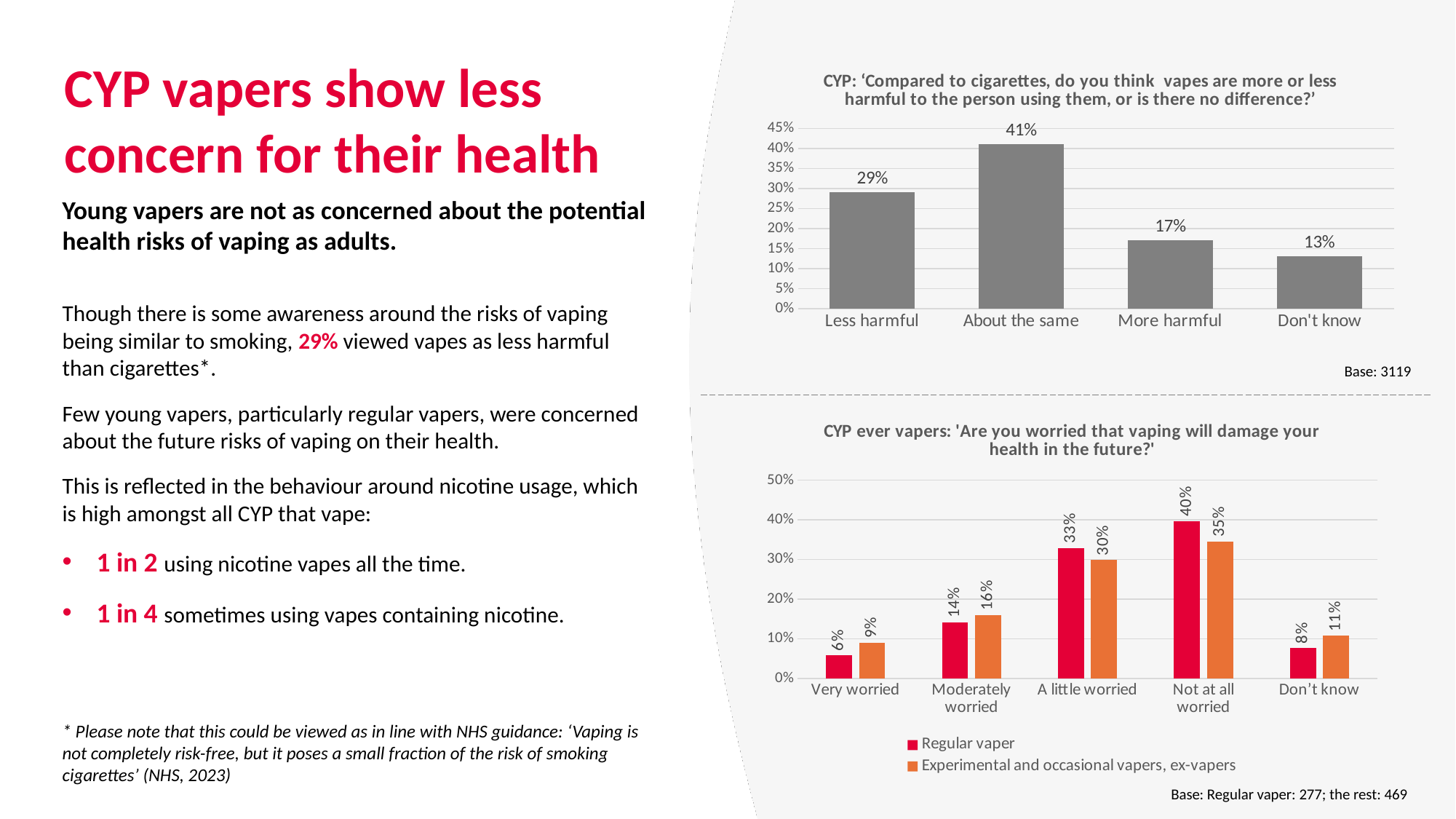
In the bottom chart ('Are you worried that vaping will damage your health in the future?'), how many series does the legend list? 2 In the bottom chart ('Are you worried that vaping will damage your health in the future?'), what is the value for Regular vapers who are 'Not at all worried'? 40% In the top chart ('Compared to cigarettes...'), what is the difference between 'Less harmful' and 'More harmful'? 12% In the top chart ('Compared to cigarettes...'), what percentage said vapes are 'About the same'? 41% In the top chart ('Compared to cigarettes...'), what is the base shown? 3119 In the top chart ('Compared to cigarettes...'), which category has the lowest value? Don't know In the top chart ('Compared to cigarettes...'), how many categories are shown on the x axis? 4 In the bottom chart ('Are you worried that vaping will damage your health in the future?'), what is the difference between the two series for 'Not at all worried'? 5% In the bottom chart ('Are you worried that vaping will damage your health in the future?'), what is the value for 'Experimental and occasional vapers, ex-vapers' who are 'Moderately worried'? 16% In the bottom chart ('Are you worried that vaping will damage your health in the future?'), which category has the lowest value for Regular vapers? Very worried In the bottom chart ('Are you worried that vaping will damage your health in the future?'), which is larger for 'A little worried': Regular vaper or Experimental and occasional vapers, ex-vapers? Regular vaper What type of chart is the bottom chart ('Are you worried that vaping will damage your health in the future?')? Bar chart